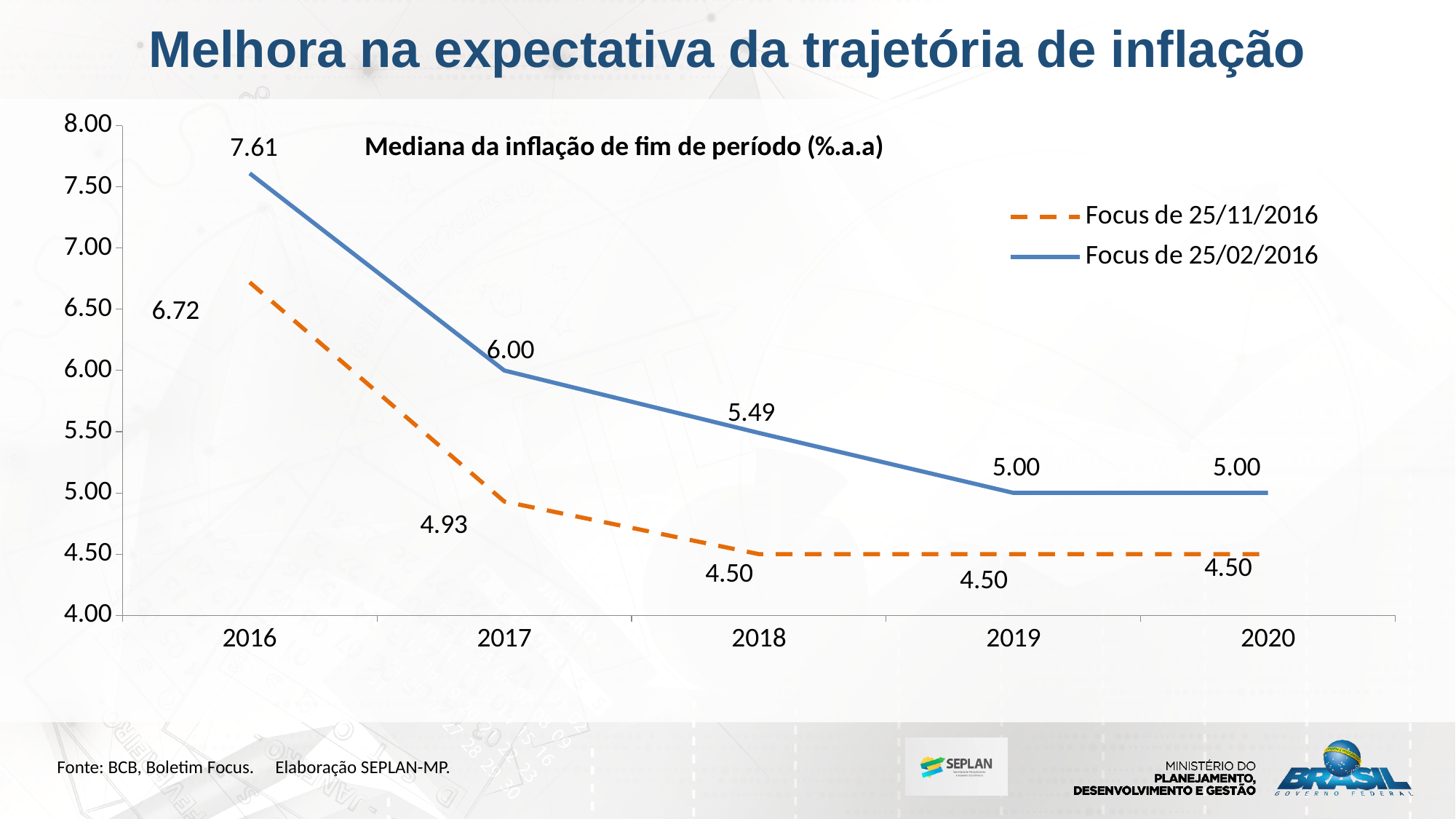
What is the value for Focus de 25/11/2016 in 2017? 4.93 What is the title printed inside the chart area? Mediana da inflação de fim de período (%.a.a) What type of chart is shown on the slide? line chart What is the value for Focus de 25/11/2016 in 2020? 4.50 How many series does the legend list? 2 What is the value for Focus de 25/02/2016 in 2018? 5.49 Which series has the larger value in 2019, Focus de 25/11/2016 or Focus de 25/02/2016? Focus de 25/02/2016 In which year is the Focus de 25/02/2016 series highest? 2016 Does the Focus de 25/11/2016 series rise or fall from 2016 to 2018? fall What is the difference between the Focus de 25/02/2016 and Focus de 25/11/2016 values in 2016? 0.89 How many years are shown on the x axis? 5 What is the value for Focus de 25/02/2016 in 2016? 7.61